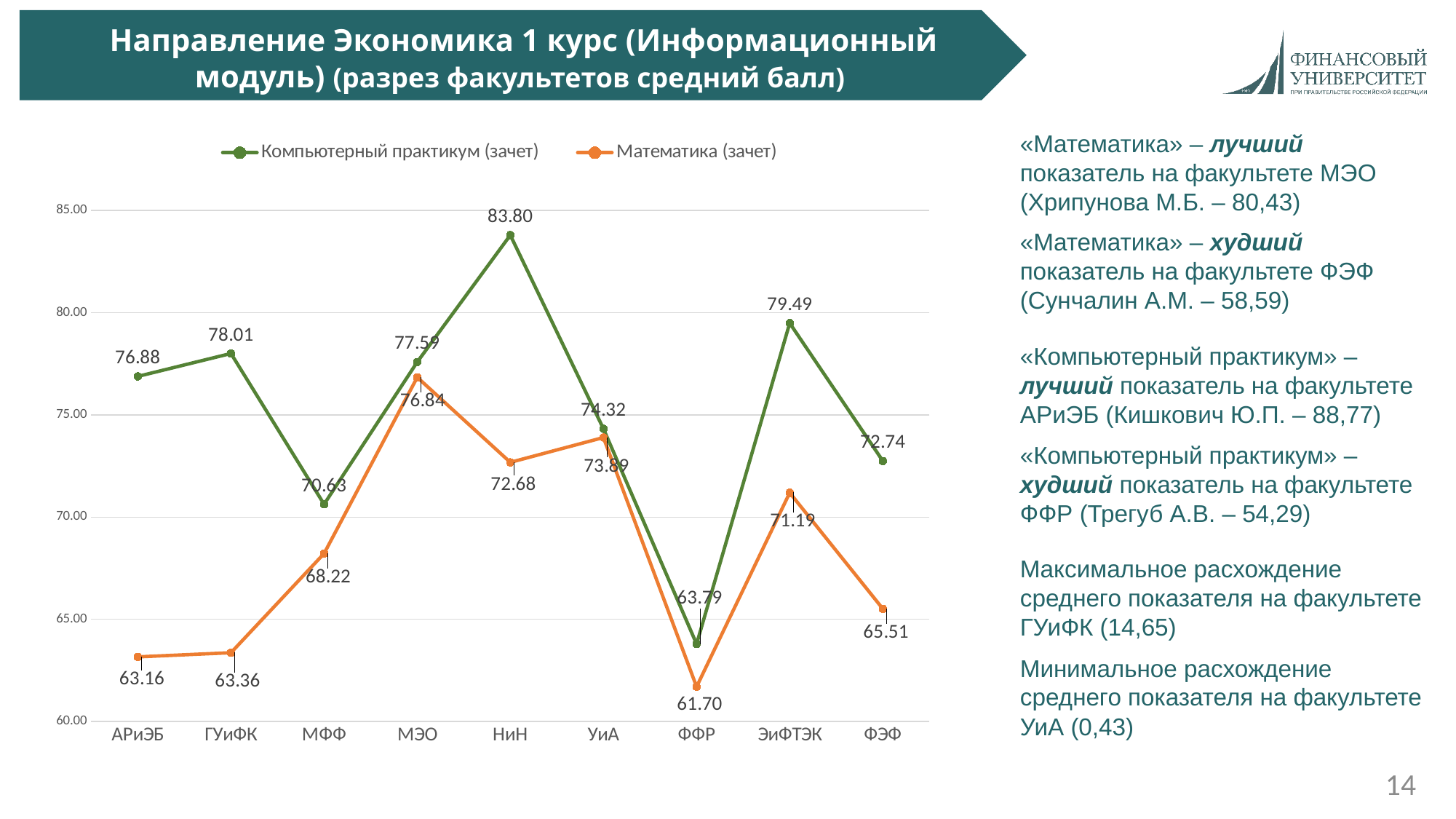
Is the value of Математика (зачет) for АРиЭБ greater or less than 65.00? less How many faculties are shown on the x axis of the chart? 9 What type of chart is shown on the slide? line chart What is the value of Математика (зачет) for МЭО? 76.84 What is the value of Компьютерный практикум (зачет) for НиН? 83.80 Which colour is used for the Математика (зачет) line? orange Which is larger for ЭиФТЭК: Компьютерный практикум (зачет) or Математика (зачет)? Компьютерный практикум (зачет) What is the value of Математика (зачет) for ФФР? 61.70 What is the difference between Компьютерный практикум (зачет) and Математика (зачет) for ГУиФК? 14.65 How many series does the chart legend list? 2 Which faculty has the lowest value for Математика (зачет)? ФФР Which faculty has the highest value for Компьютерный практикум (зачет)? НиН